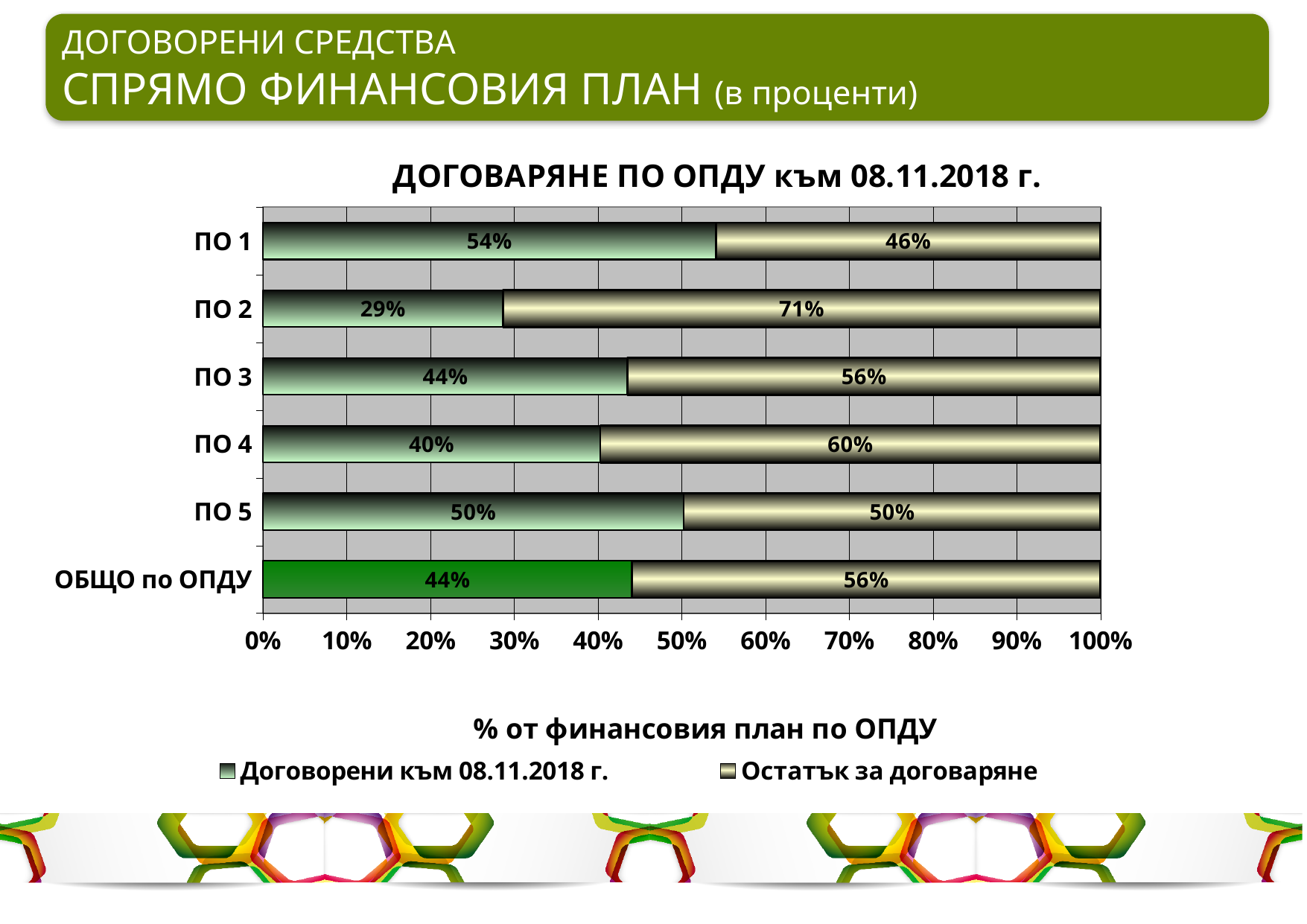
What is the total of the stacked bar for ПО 5? 100% What is the value of "Договорени към 08.11.2018 г." for ОБЩО по ОПДУ? 44% Which category has the highest value for "Договорени към 08.11.2018 г."? ПО 1 How many categories are shown on the chart? 6 Which category has the lowest value for "Договорени към 08.11.2018 г."? ПО 2 What is the value of "Остатък за договаряне" for ПО 2? 71% What is the difference between the "Остатък за договаряне" values for ПО 2 and ПО 1? 25% Which is larger: the "Договорени към 08.11.2018 г." value for ПО 3 or for ПО 4? ПО 3 What is the title of the chart? ДОГОВАРЯНЕ ПО ОПДУ към 08.11.2018 г. How many series does the legend list? 2 What kind of chart is shown on the slide? Stacked bar chart What is the value of "Договорени към 08.11.2018 г." for ПО 1? 54%